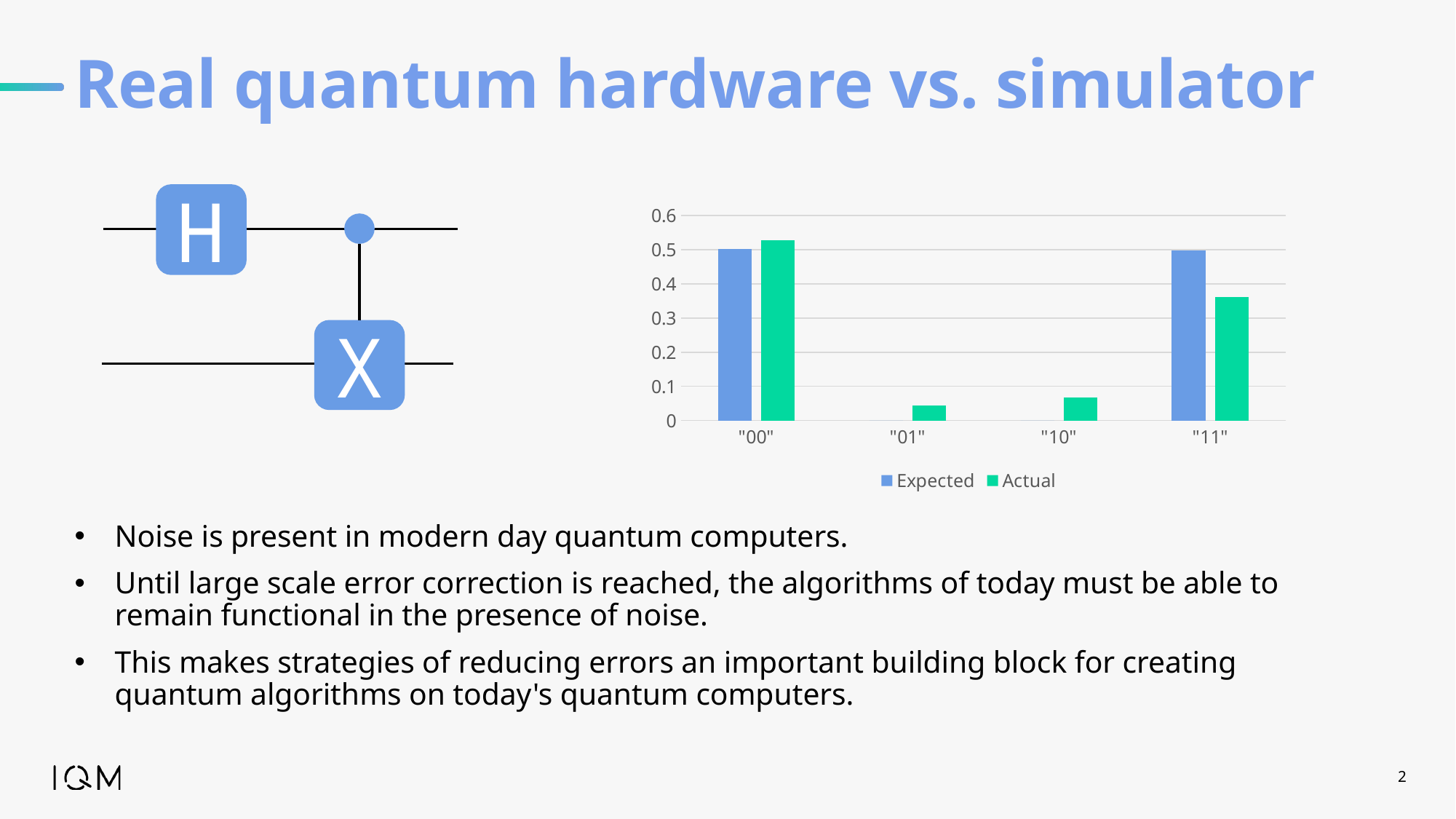
Is the Actual value for "01" greater or less than 0.1? less What are the two series named in the chart's legend? Expected and Actual How many series does the chart's legend list? 2 Is the Actual value for "11" greater or less than 0.4? less How many categories are shown on the x axis of the chart? 4 Which category has the highest Actual value? "00" What kind of chart is shown on the slide? bar chart For "11", which is larger, the Expected value or the Actual value? Expected Which category has the lowest Actual value? "01" For "10", which is larger, the Expected value or the Actual value? Actual What colour are the Actual bars in the chart? green